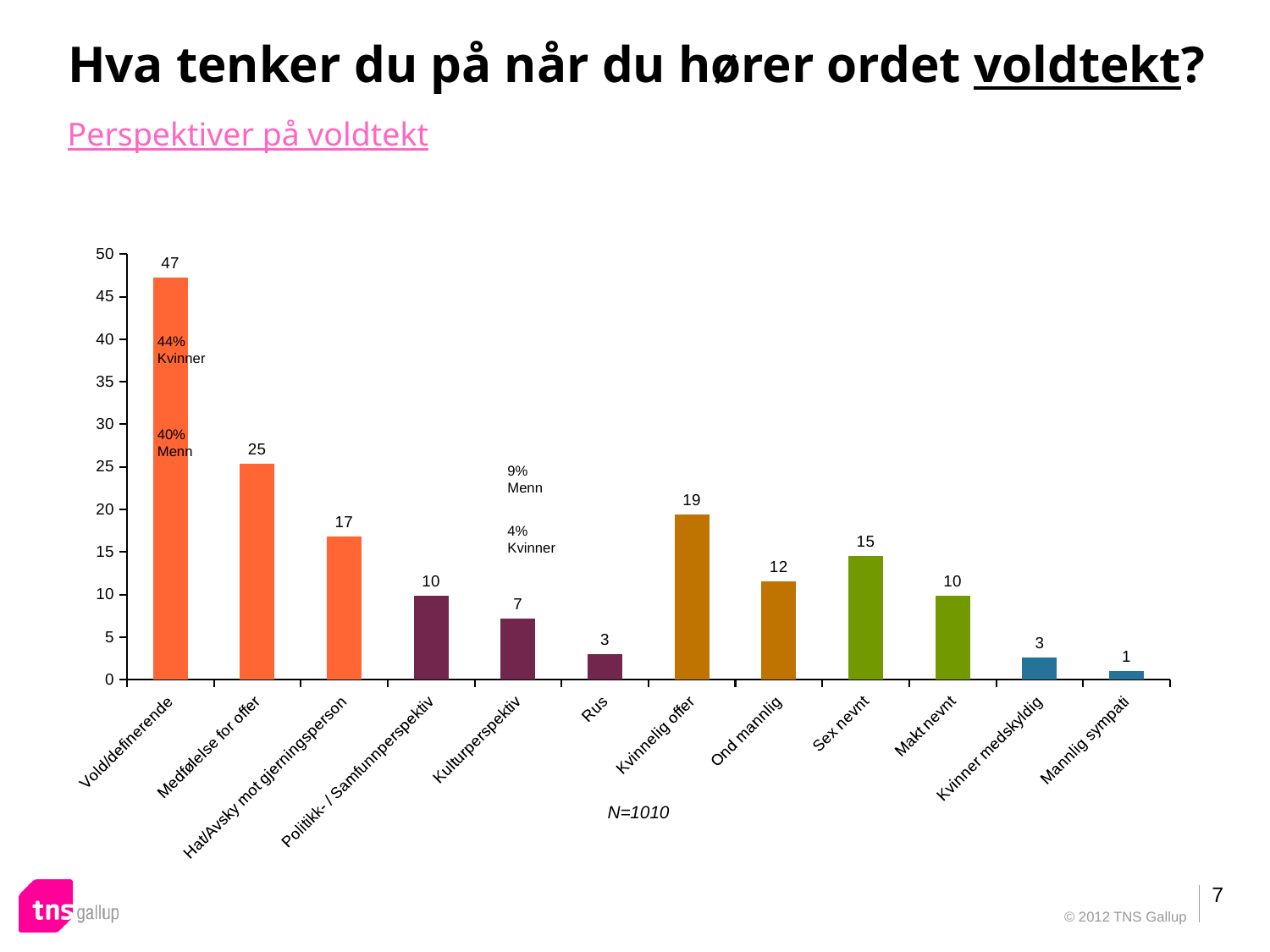
Which category has the lowest value? Mannlig sympati What is the value for Sex nevnt? 15 How many categories are shown on the x axis? 12 Which category has the highest value? Vold/definerende What sample size (N) is noted below the chart? N=1010 What is the value for Kvinnelig offer? 19 What is the difference between the values for Kvinnelig offer and Ond mannlig? 7 What is the value for Vold/definerende? 47 What is the difference between the values for Vold/definerende and Medfølelse for offer? 22 Which is larger, the value for Ond mannlig or the value for Makt nevnt? Ond mannlig What is the value for Kulturperspektiv? 7 What kind of chart is shown on the slide? Bar chart